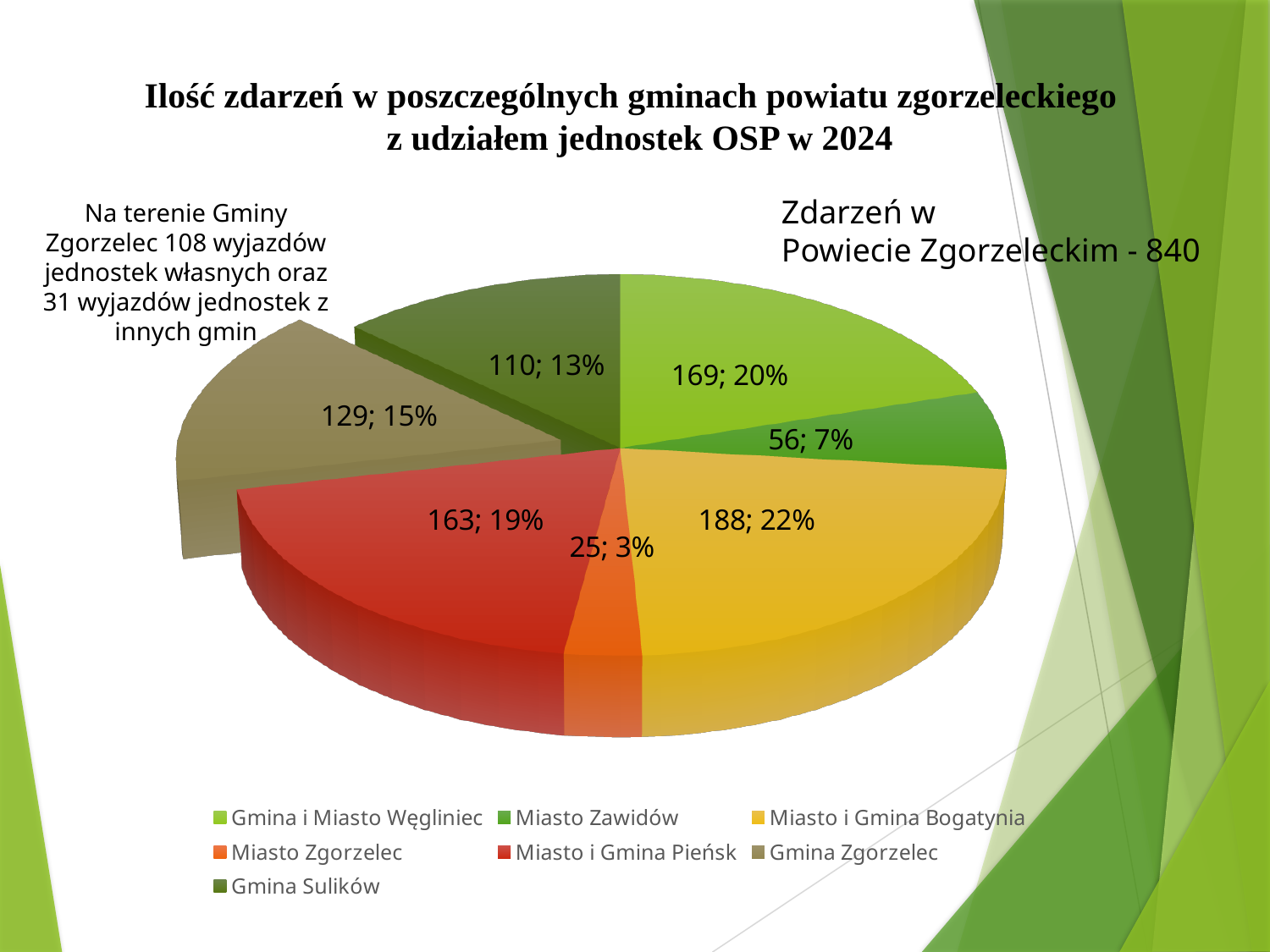
How many entries does the legend list? 7 What is the total number of incidents in Powiat Zgorzelecki stated on the slide? 840 What is the number of incidents for Gmina i Miasto Węgliniec? 169 Which is larger, the value for Gmina Sulików or the value for Gmina Zgorzelec? Gmina Zgorzelec Which category has the largest slice in the pie chart? Miasto i Gmina Bogatynia What percentage share does Gmina Zgorzelec have in the pie chart? 15% Which category has the smallest slice in the pie chart? Miasto Zgorzelec What kind of chart is shown on the slide? pie chart What is the difference between the values for Miasto i Gmina Bogatynia and Miasto i Gmina Pieńsk? 25 What is the number of incidents for Miasto i Gmina Bogatynia? 188 How many slices does the pie chart have? 7 What percentage share does Miasto Zawidów have in the pie chart? 7%